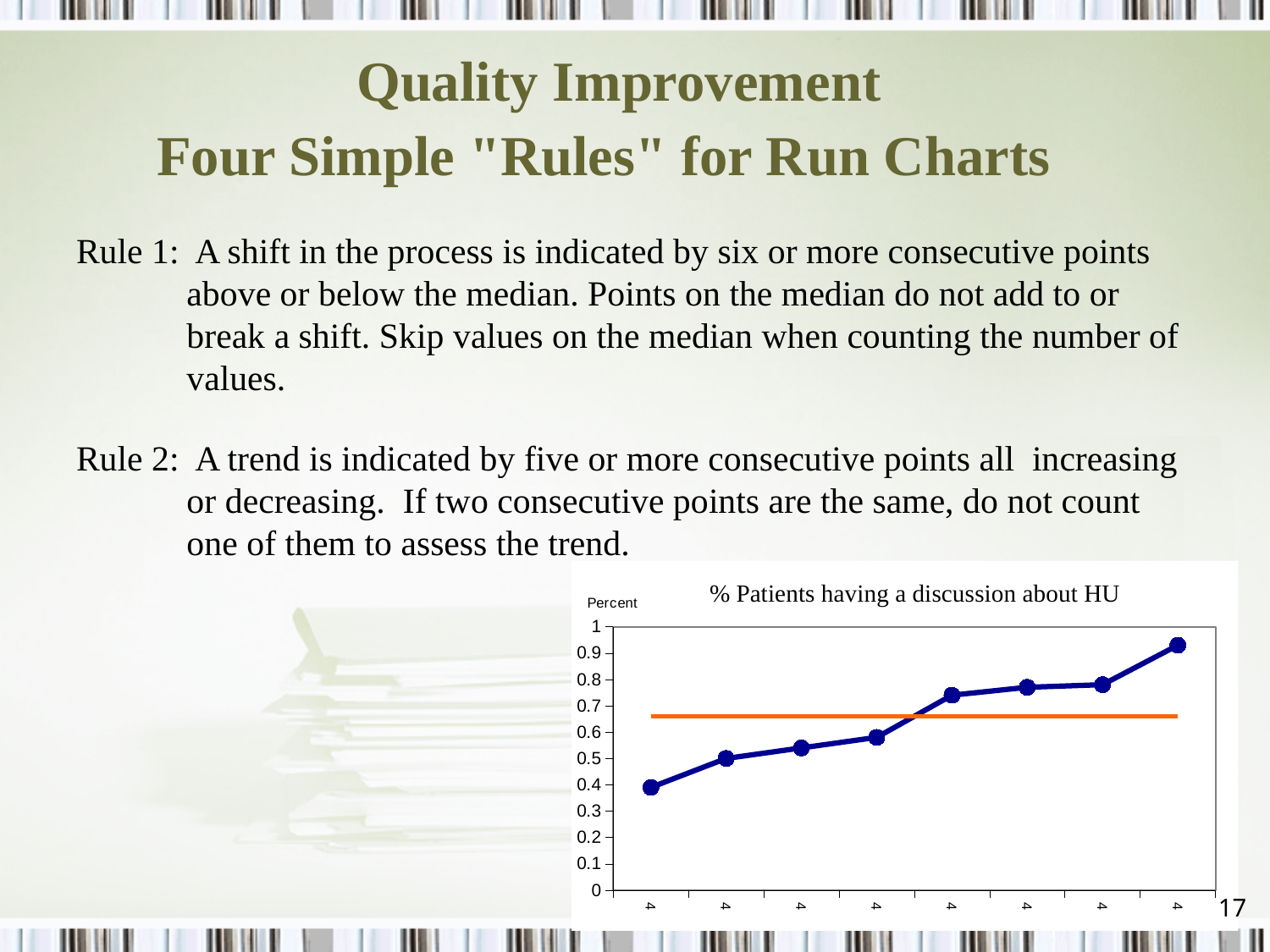
Do the values on the blue line rise or fall from left to right along the x axis? rise What kind of chart is shown on the slide? line chart What label is shown on the vertical axis of the chart? Percent What is the title of the chart on the slide? % Patients having a discussion about HU Is the value of the last (rightmost) point on the blue line greater or less than 0.9? greater Is the value of the last (rightmost) point on the blue line larger or smaller than the value of the first (leftmost) point? larger How many data points are plotted on the blue line in the chart? 8 Is the value of the fifth point from the left on the blue line greater or less than 0.7? greater Is the value of the third point from the left on the blue line greater or less than 0.5? greater Which data point on the blue line has the lowest value, the leftmost or the rightmost? leftmost Which data point on the blue line has the highest value, the leftmost or the rightmost? rightmost